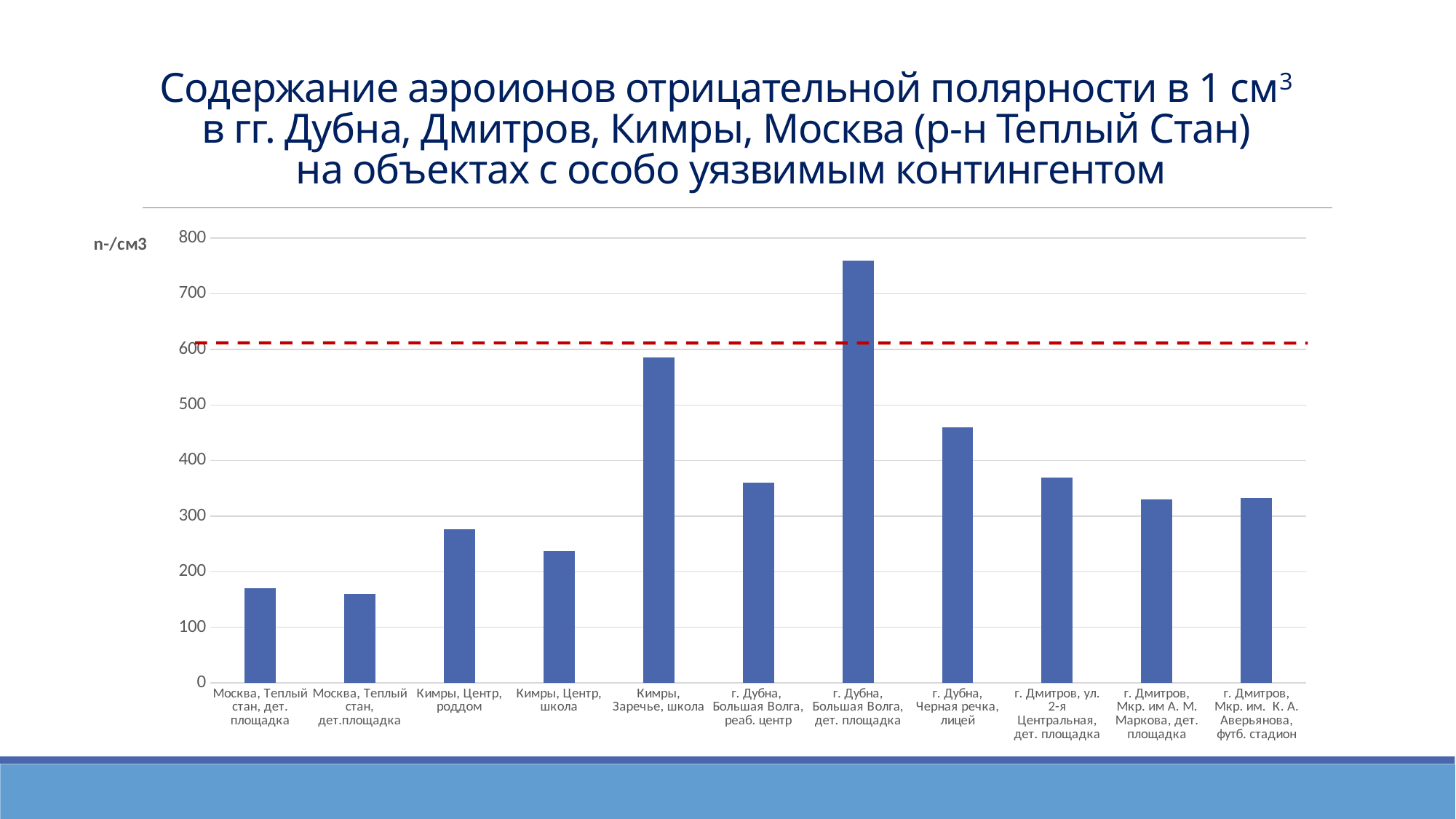
Which category has the highest value in the chart? г. Дубна, Большая Волга, дет. площадка Is the value for г. Дмитров, ул. 2-я Центральная, дет. площадка greater or less than 300? greater Which is larger: the value for Кимры, Заречье, школа or the value for г. Дубна, Черная речка, лицей? Кимры, Заречье, школа Which is larger: the value for Кимры, Центр, роддом or the value for Кимры, Центр, школа? Кимры, Центр, роддом Is the value for г. Дубна, Черная речка, лицей greater or less than 500? less Is the value for г. Дубна, Большая Волга, дет. площадка greater or less than 700? greater What unit label is shown next to the vertical axis of the chart? n-/см3 What kind of chart is shown on the slide? bar chart How many bars (categories) are plotted in the chart? 11